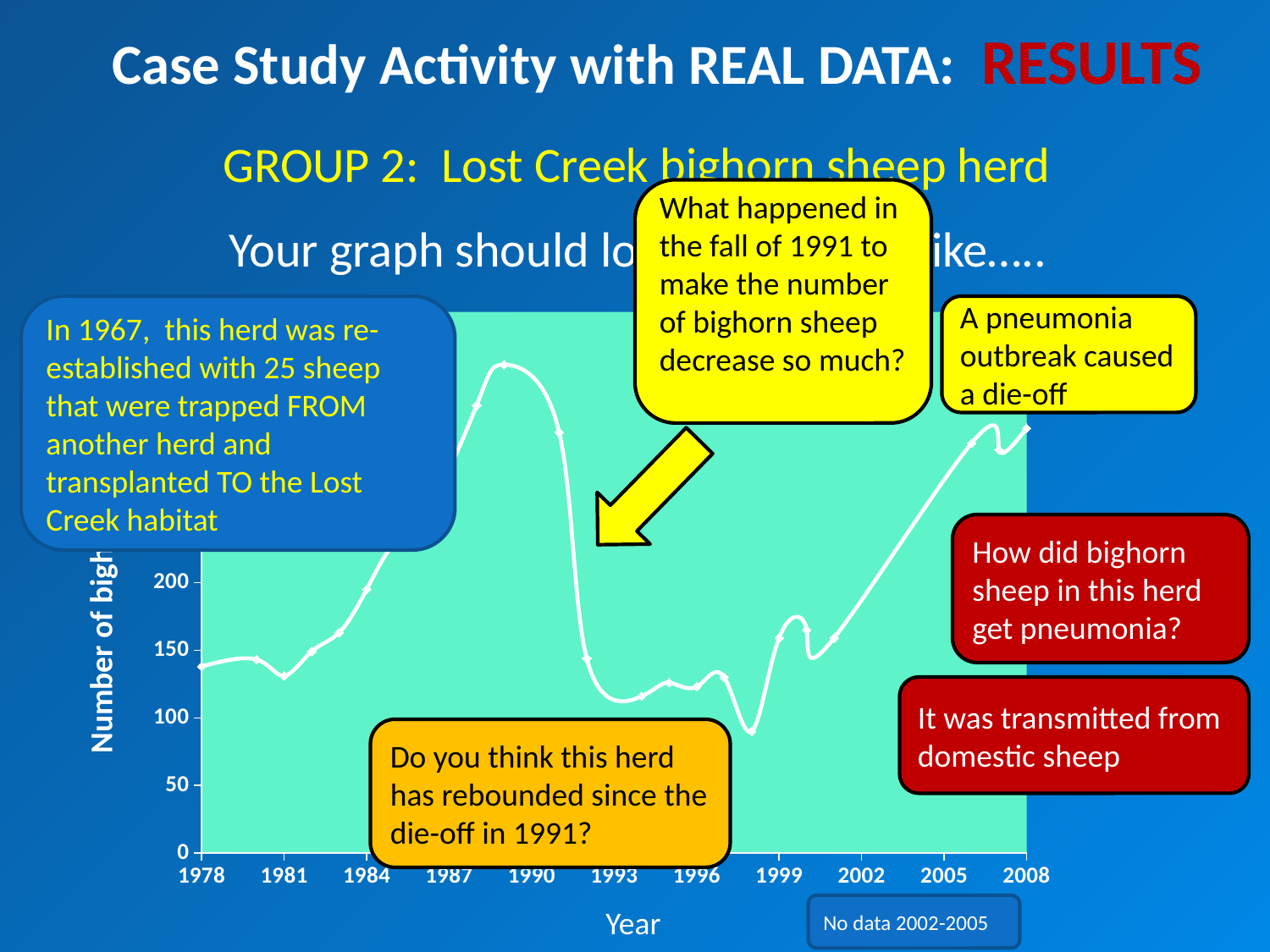
Is the value for 1987 greater or less than 200? greater Does the number of sheep rise or fall between 1990 and 1993? fall Which years does the note on the chart say have no data? 2002-2005 Is the value for 2008 greater or less than 200? greater Is the value for 1978 greater or less than 150? less What kind of chart is shown on the slide? line chart What is the label on the x axis of the chart? Year How many year labels are shown along the x axis of the chart? 11 Does the number of sheep rise or fall between 1999 and 2008? rise